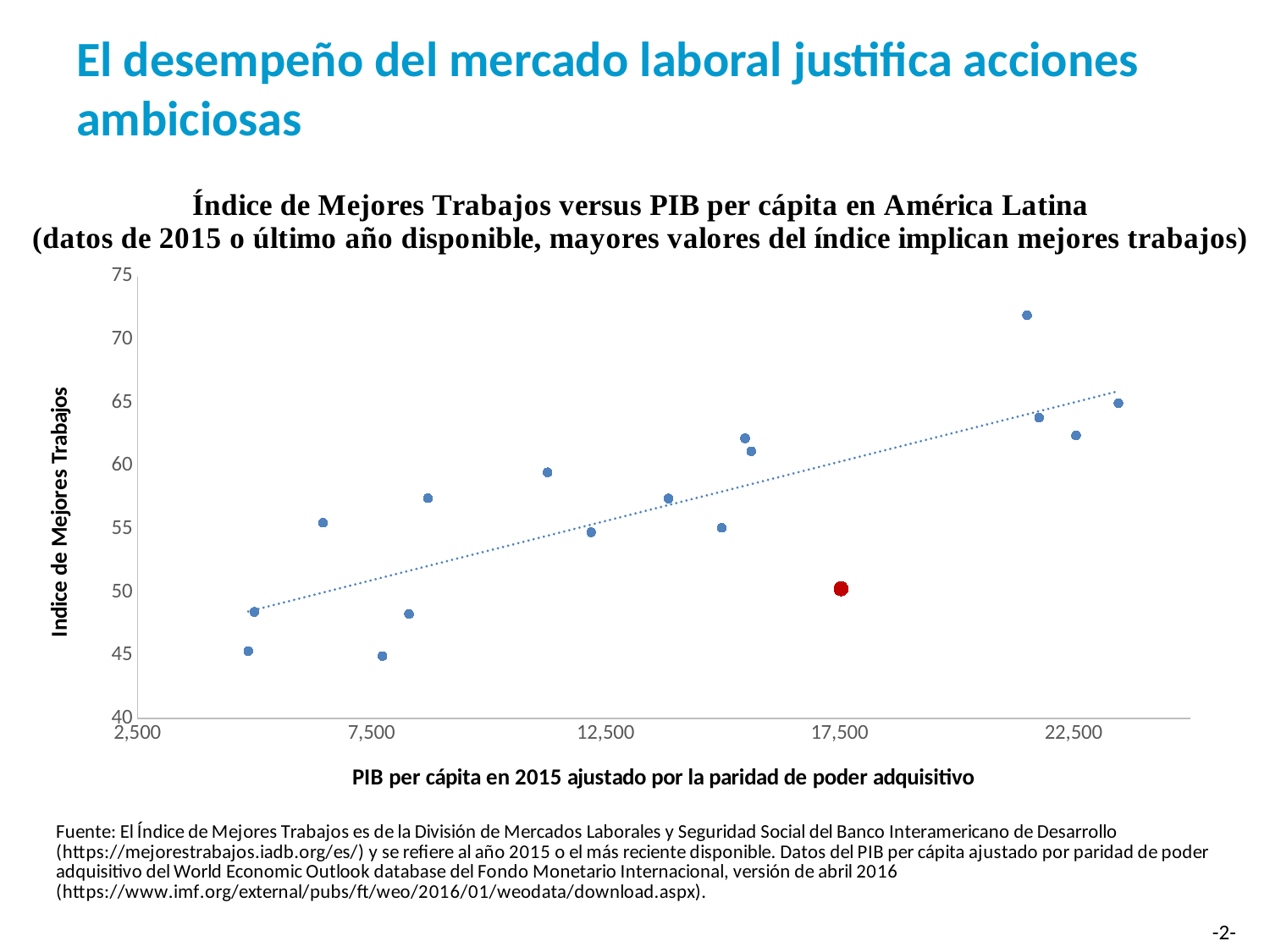
Is the Índice de Mejores Trabajos value of the highest point greater or less than 70? greater What is the lowest value shown on the vertical axis? 40 What kind of chart is shown on the slide? Scatter chart What is the title of the chart? Índice de Mejores Trabajos versus PIB per cápita en América Latina Is the Índice de Mejores Trabajos value of the lowest point greater or less than 50? less Is the Índice de Mejores Trabajos value for the red point greater or less than 55? less As PIB per cápita increases along the x axis, does the Índice de Mejores Trabajos generally rise or fall? Rise What is the label of the vertical axis? Indice de Mejores Trabajos Which has a higher Índice de Mejores Trabajos: the red point or the highest blue point? The highest blue point